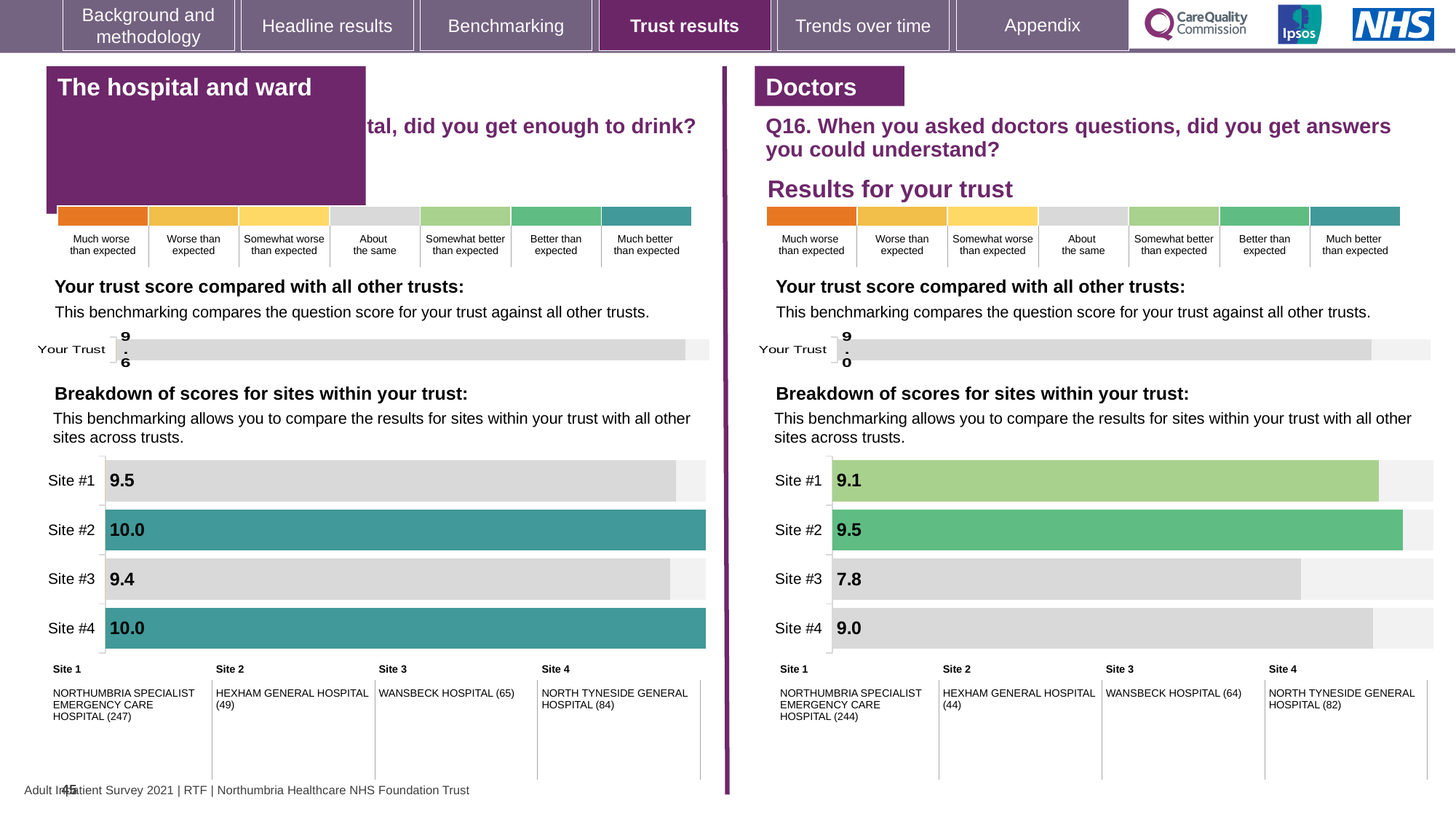
In the right-hand (Q16) site breakdown chart, which is larger, the score for Site #1 or Site #4? Site #1 In the left-hand site breakdown chart, which site has the lowest score? Site #3 How many sites are shown in the left-hand 'Breakdown of scores for sites within your trust' chart? 4 In the right-hand (Q16) 'Breakdown of scores for sites within your trust' chart, what is the score for Site #3? 7.8 In the left-hand 'Breakdown of scores for sites within your trust' chart, what is the score for Site #1? 9.5 In the right-hand (Q16) 'Your trust score compared with all other trusts' chart, what is the score for Your Trust? 9.0 In the right-hand (Q16) site breakdown chart, which site has the highest score? Site #2 What type of chart is used for the right-hand (Q16) 'Breakdown of scores for sites within your trust'? Bar chart In the right-hand (Q16) site breakdown chart, what is the difference between the scores for Site #2 and Site #3? 1.7 In the left-hand site breakdown chart, what is the difference between the scores for Site #2 and Site #3? 0.6 In the left-hand 'Your trust score compared with all other trusts' chart, what is the score for Your Trust? 9.6 In the right-hand (Q16) site breakdown chart, which site has the lowest score? Site #3